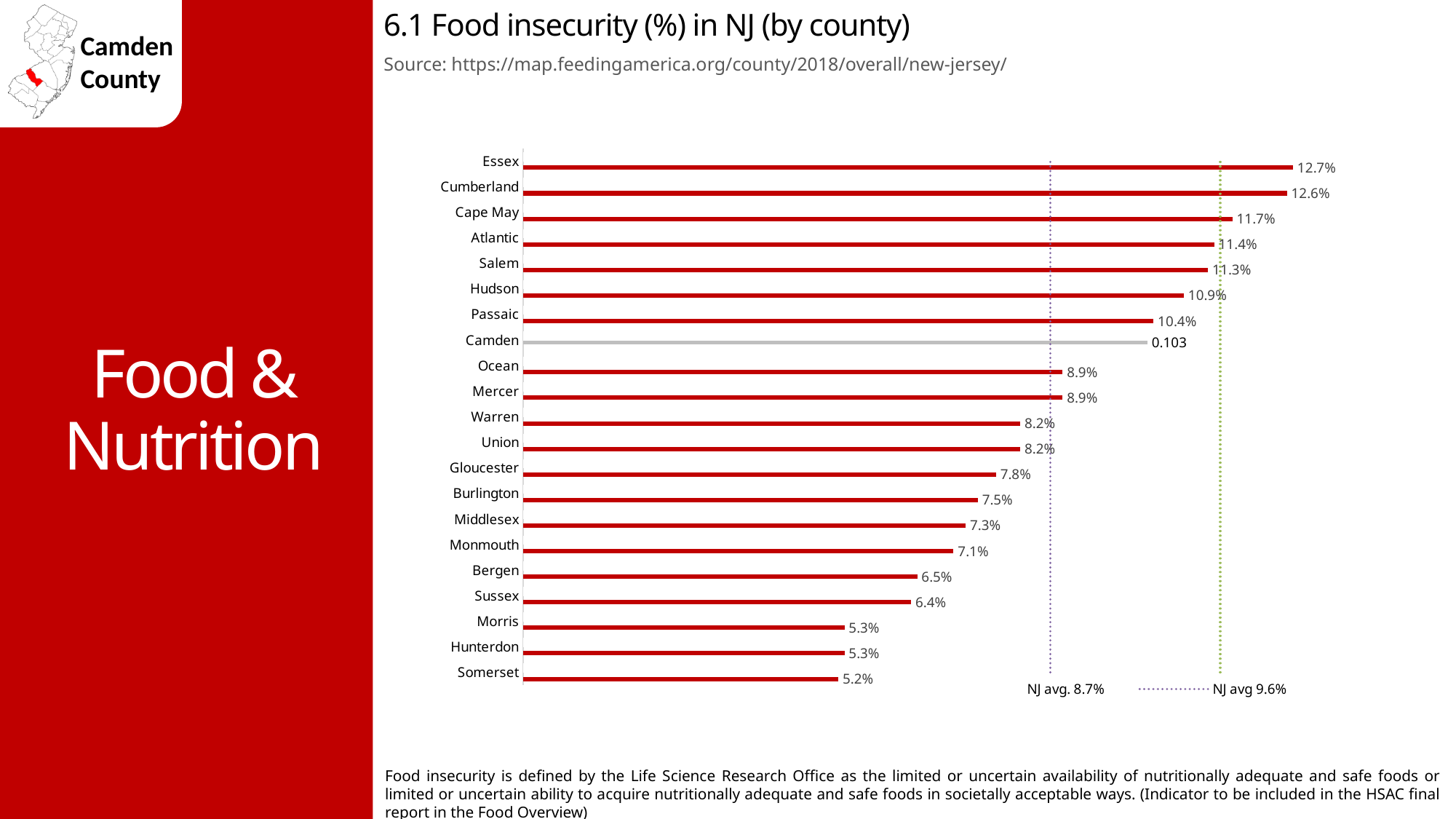
What value is labeled on the Camden bar? 0.103 Which county has a higher food insecurity value, Bergen or Monmouth? Monmouth What two NJ average values are marked by the dotted reference lines? 8.7% and 9.6% Which county's bar is drawn in grey instead of red? Camden What is the food insecurity value shown for Burlington county? 7.5% How many counties are listed on the chart? 21 What kind of chart is used to show food insecurity by county? Bar chart What is the food insecurity value shown for Essex county? 12.7% Which county has the lowest food insecurity value on the chart? Somerset Which county has the highest food insecurity value on the chart? Essex What is the food insecurity value shown for Gloucester county? 7.8% What is the difference between the food insecurity values for Cape May and Hudson? 0.8%